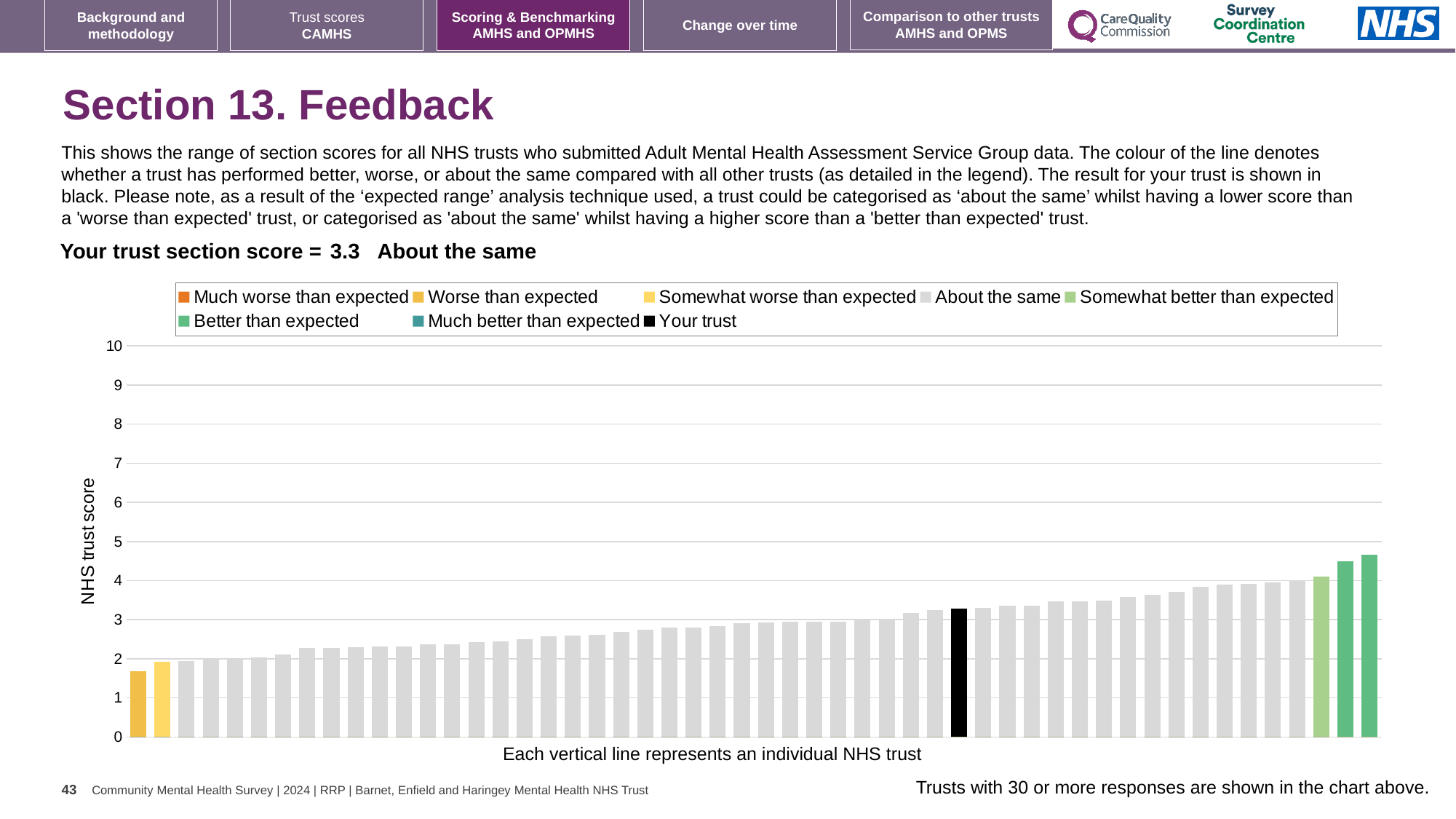
What is the label on the y axis of the chart? NHS trust score Is the value for your trust (the black bar) greater or less than 3? greater What is the section score for your trust? 3.3 Do the bar values rise or fall from left to right along the x axis? rise Is the value for the tallest bar greater or less than 4? greater How many entries does the chart legend list? 8 Is the value for the shortest bar greater or less than 2? less What colour is the bar representing your trust? black How is your trust's section score categorised compared with other trusts? About the same How many green bars (somewhat better or better than expected) are shown at the right of the chart? 3 What is the highest value shown on the y axis? 10 What kind of chart is shown on the slide? bar chart